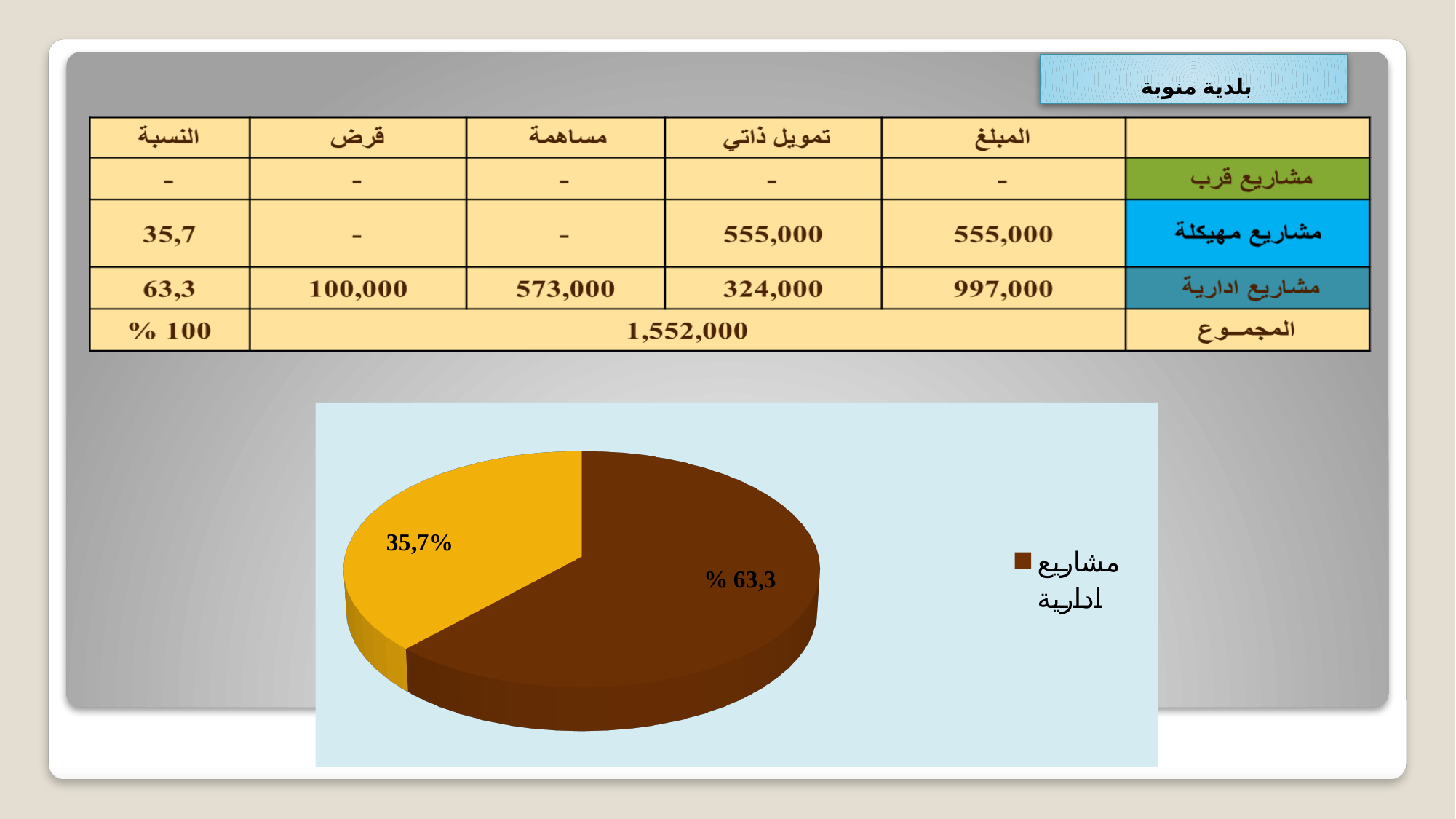
How many entries does the pie chart's legend list? 1 Which is larger in the pie chart, the brown slice or the yellow slice? the brown slice What is the only entry listed in the pie chart's legend? مشاريع ادارية Which slice of the pie chart is the largest? مشاريع ادارية (brown, 63,3%) What share of the pie does the slice for مشاريع ادارية represent? 63,3% How many slices does the pie chart have? 2 What kind of chart is shown on the slide? pie chart What percentage is shown on the smallest slice of the pie chart? 35,7% What percentage is printed on the brown slice of the pie chart? 63,3% What colour is the slice for مشاريع ادارية in the pie chart? brown By how many percentage points does the brown slice exceed the yellow slice in the pie chart? 27,6 What percentage is printed on the yellow slice of the pie chart? 35,7%